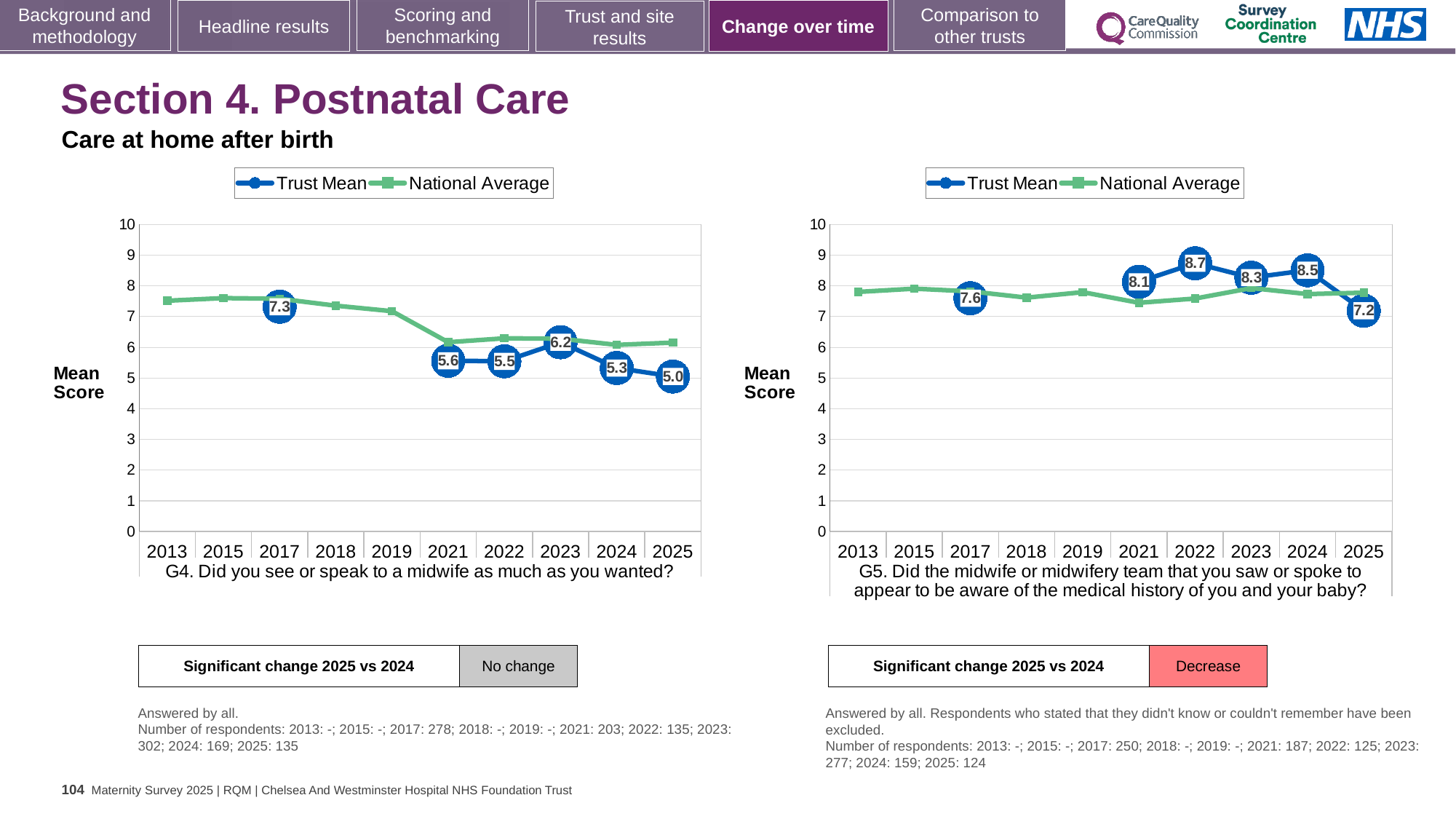
How many series does the legend of the right chart (G5) list? 2 In the left chart (G4), what is the difference between the Trust Mean in 2017 and in 2025? 2.3 In the left chart (G4), what is the Trust Mean for 2025? 5.0 In the right chart (G5), which year has the lowest labelled Trust Mean? 2025 In the right chart (G5), which year has the larger Trust Mean, 2021 or 2023? 2023 What kind of chart is used for G4 on the left? Line chart In the right chart (G5), which year has the highest Trust Mean? 2022 In the left chart (G4), which year has the highest labelled Trust Mean? 2017 In the left chart (G4), which year has the lowest labelled Trust Mean? 2025 In the left chart (G4), is the National Average for 2013 greater or less than 7? greater In the right chart (G5), what is the Trust Mean for 2022? 8.7 In the right chart (G5), what is the difference between the Trust Mean in 2024 and in 2025? 1.3